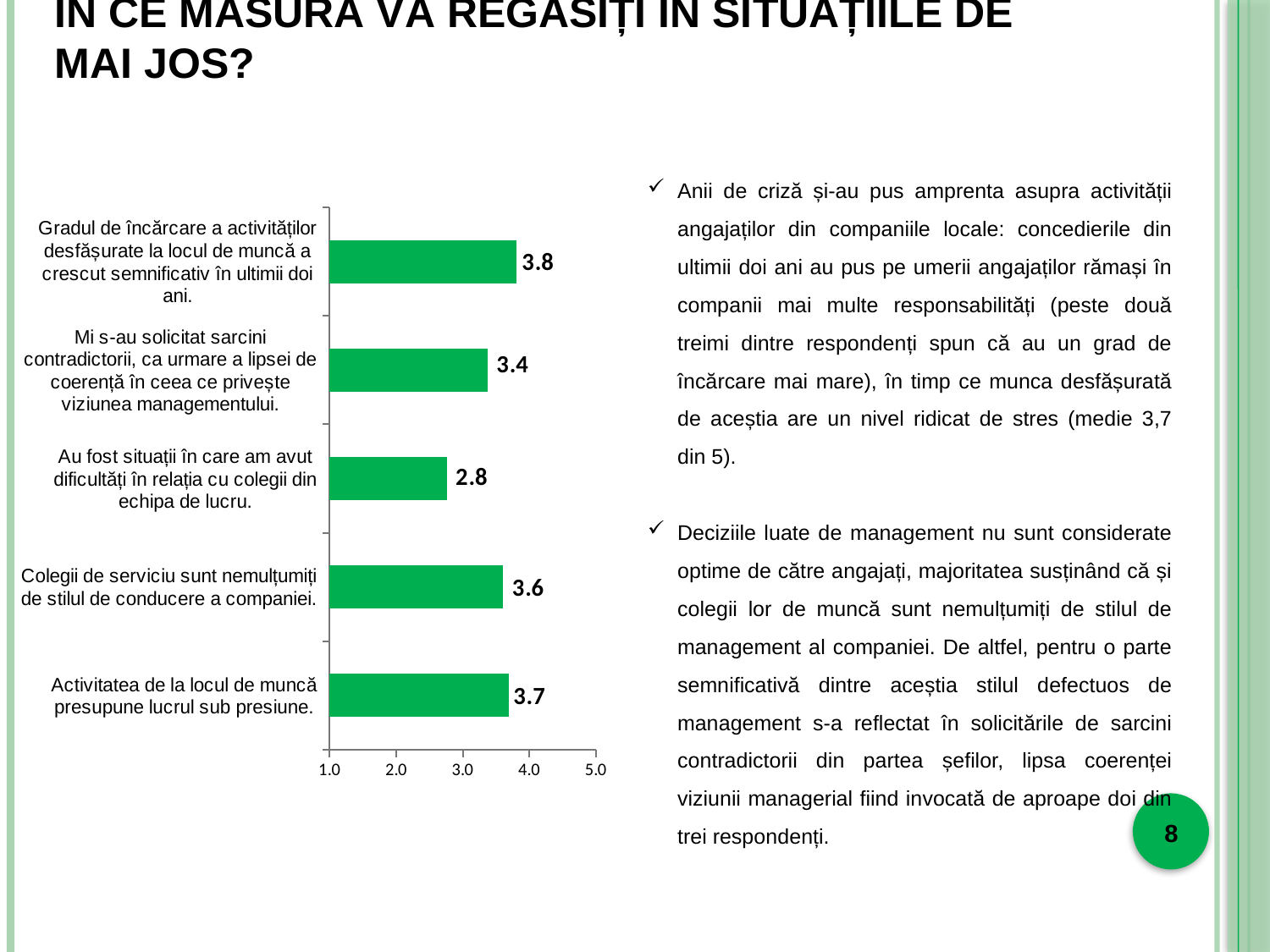
Which category has the lowest value? Au fost situații în care am avut dificultăți în relația cu colegii din echipa de lucru. Which is larger: the value for "Mi s-au solicitat sarcini contradictorii..." or the value for "Colegii de serviciu sunt nemulțumiți de stilul de conducere a companiei."? Colegii de serviciu sunt nemulțumiți de stilul de conducere a companiei. What is the value for "Colegii de serviciu sunt nemulțumiți de stilul de conducere a companiei."? 3.6 What is the value for "Au fost situații în care am avut dificultăți în relația cu colegii din echipa de lucru."? 2.8 How many categories are shown in the chart? 5 What is the difference between the highest value (3.8) and the lowest value (2.8)? 1.0 What is the maximum value shown on the chart's value axis? 5.0 Is the value for "Au fost situații în care am avut dificultăți în relația cu colegii din echipa de lucru." greater or less than 3.0? less What kind of chart is shown on the slide? bar chart What colour are the bars in the chart? green What is the value for "Activitatea de la locul de muncă presupune lucrul sub presiune."? 3.7 Which category has the highest value? Gradul de încărcare a activităților desfășurate la locul de muncă a crescut semnificativ în ultimii doi ani.